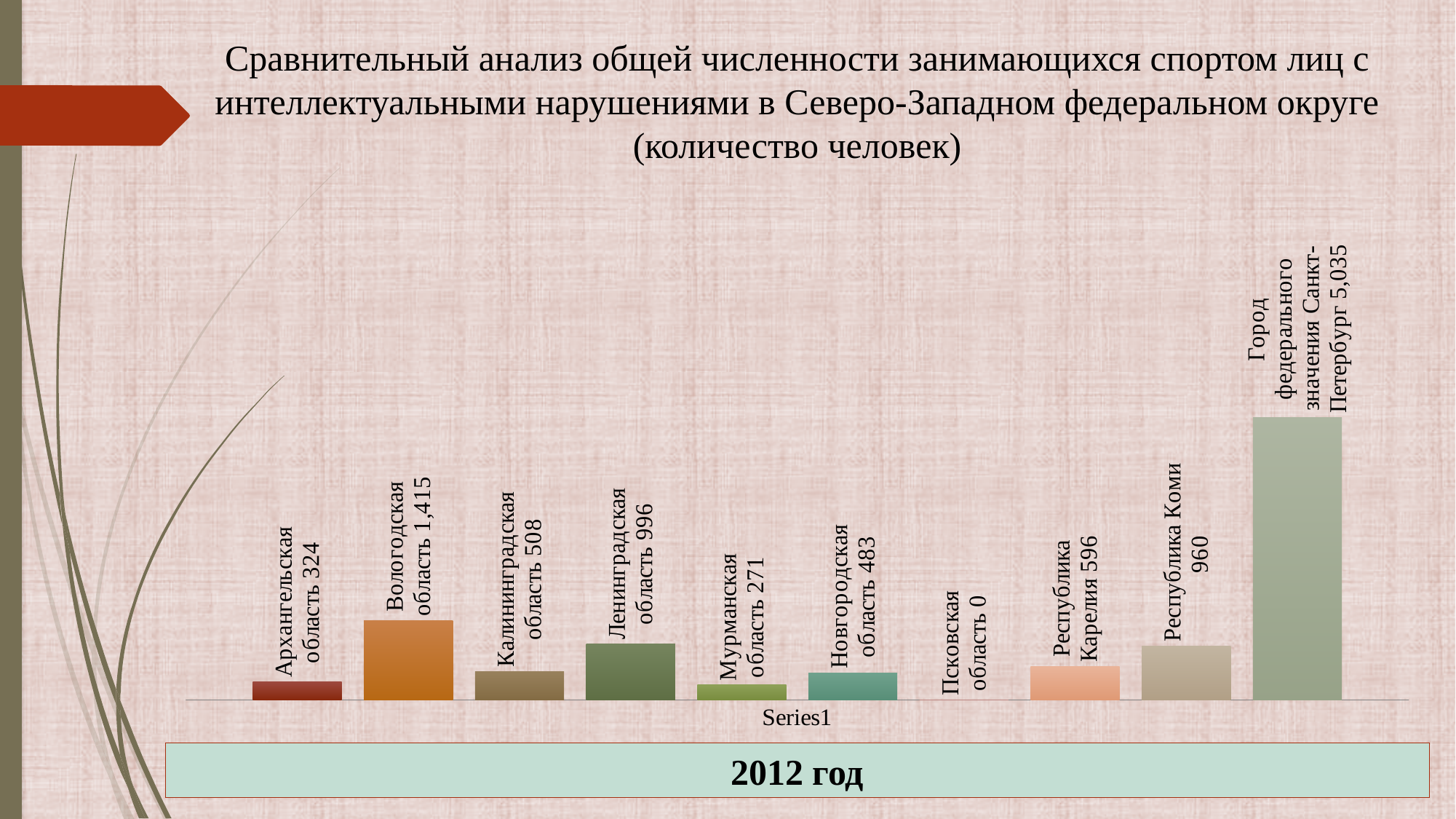
What is the value for Вологодская область? 1,415 Which category has the highest value? Город федерального значения Санкт-Петербург Which is larger, the value for Архангельская область or the value for Мурманская область? Архангельская область How many categories are shown in the chart? 10 What kind of chart is shown on the slide? Bar chart What is the difference between the values for Ленинградская область and Калининградская область? 488 What is the difference between the values for Республика Карелия and Новгородская область? 113 What year is indicated below the chart? 2012 год What is the value for Мурманская область? 271 Which is larger, the value for Республика Коми or the value for Ленинградская область? Ленинградская область Which category has the lowest value? Псковская область What is the value for Республика Коми? 960